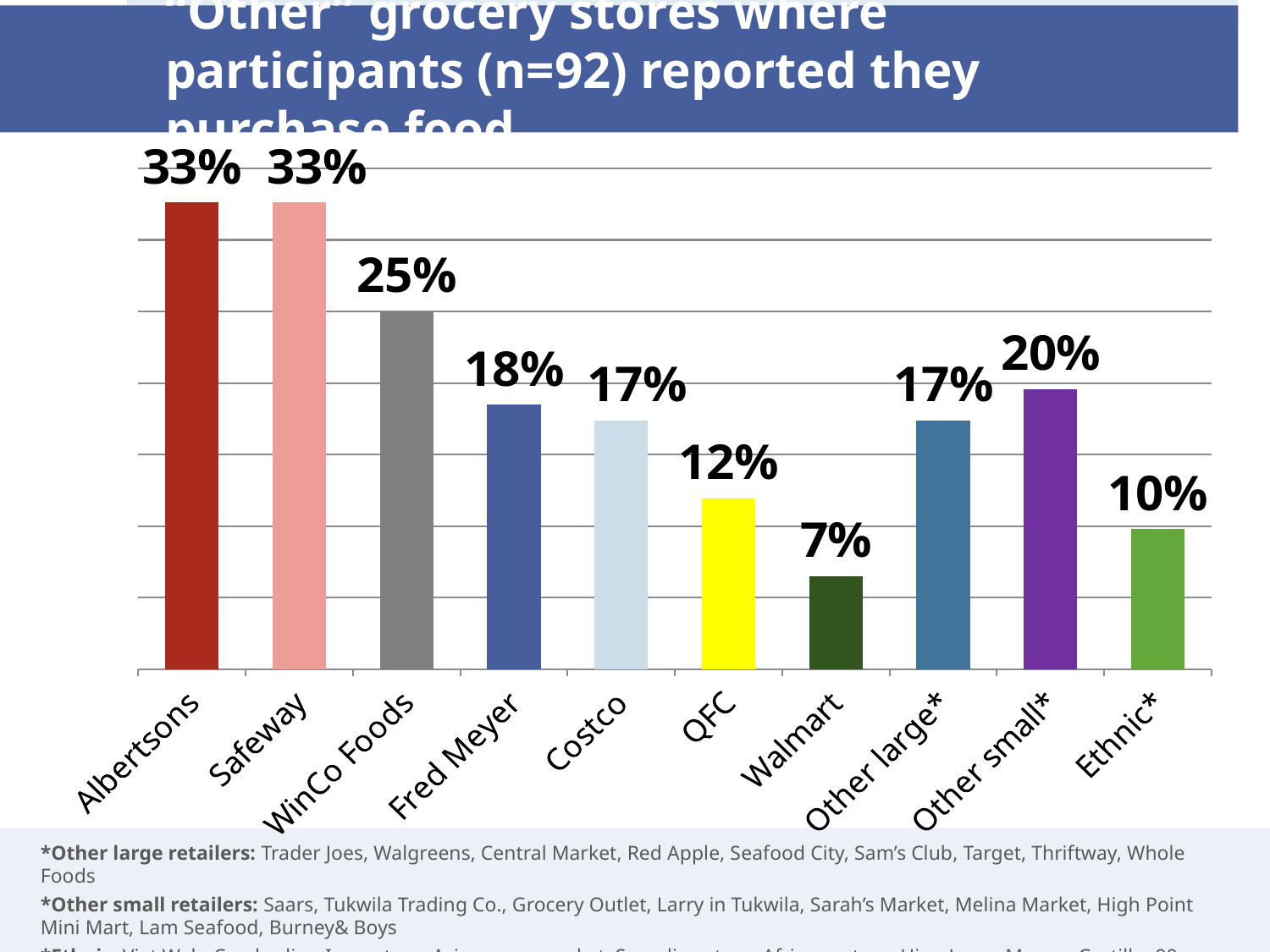
Which has a higher percentage, QFC or Costco? Costco Which has a higher value, Fred Meyer or Other large*? Fred Meyer Which store has the lowest percentage in the chart? Walmart How many store categories are shown on the x axis? 10 What is the difference between the percentages for WinCo Foods and Fred Meyer? 7% What is the value shown for Walmart? 7% What type of chart is shown on the slide? Bar chart What percentage of participants reported purchasing food at WinCo Foods? 25% What is the difference between the values for Other small* and Ethnic*? 10% Which two stores share the highest percentage in the chart? Albertsons and Safeway What percentage is shown for Other small* retailers? 20% What is the value for Ethnic* stores? 10%